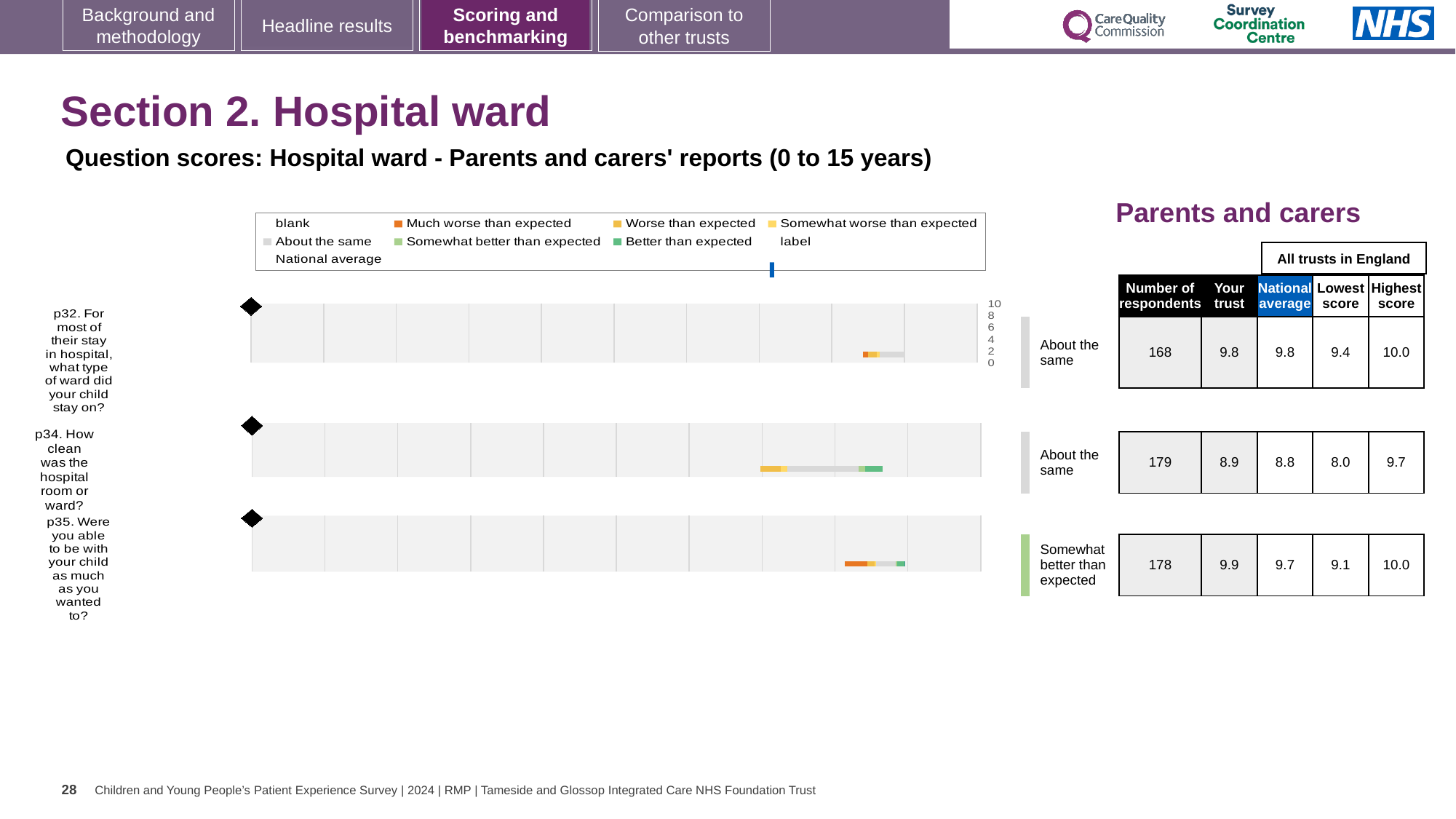
How many questions (categories) are plotted in the chart on this slide? 3 Which of the three plotted questions has the lowest 'Your trust' score? p34 In the table next to the chart, how many respondents answered p35 (were you able to be with your child as much as you wanted to)? 178 In the table next to the chart, what is the highest score across all trusts in England for p34? 9.7 What benchmark category is shown for p35 next to the chart? Somewhat better than expected What kind of chart is used to show the question scores on this slide? bar chart Which of the three plotted questions has the highest 'Your trust' score? p35 In the table next to the chart, what is the national average for p34 (how clean was the hospital room or ward)? 8.8 For p34, is the 'Your trust' score or the national average larger? Your trust What is the difference between the highest score and the lowest score for p34? 1.7 What colour does the legend use for 'Better than expected'? green In the table next to the chart, what is the 'Your trust' score for p32 (what type of ward did your child stay on)? 9.8